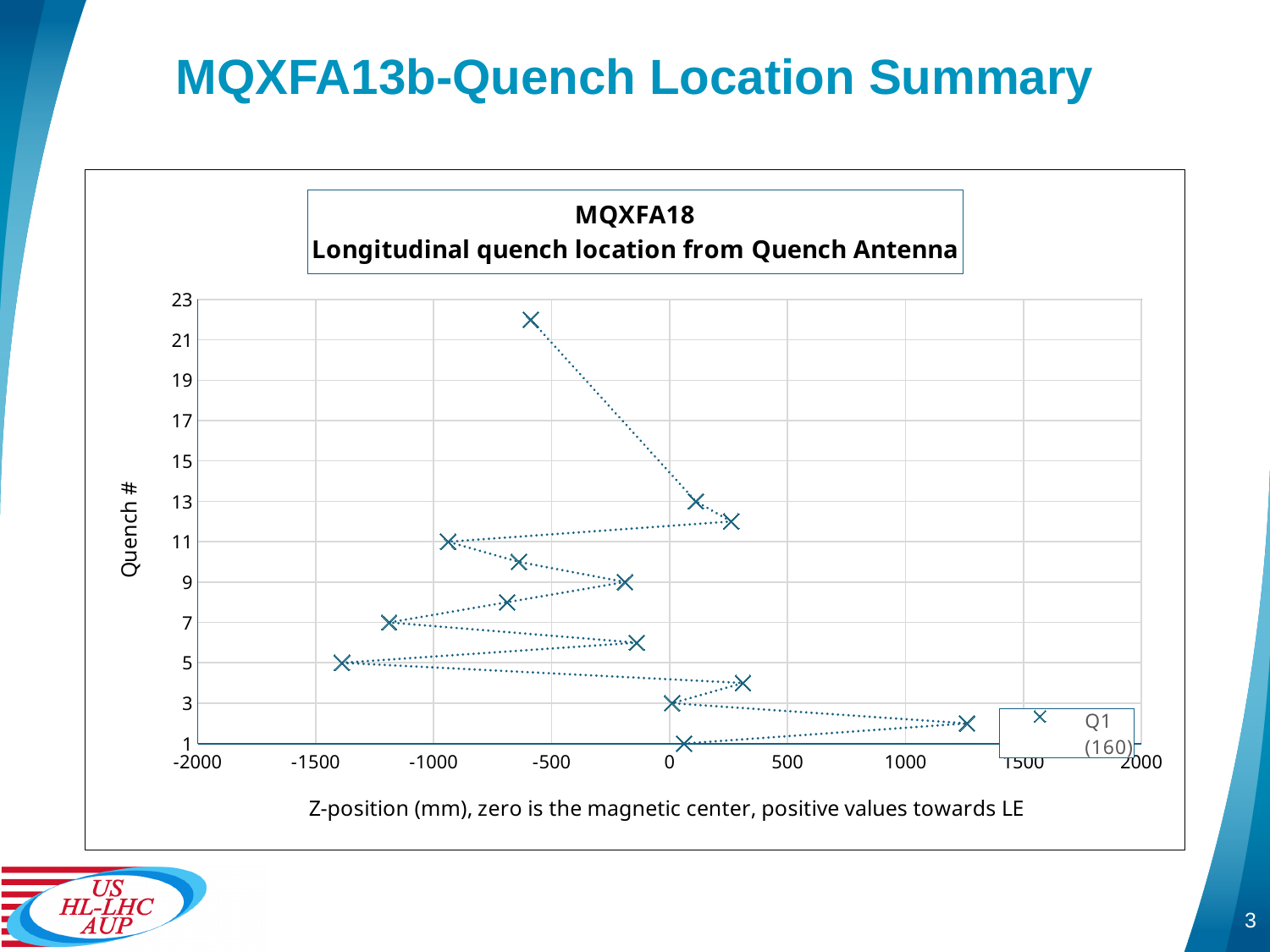
Is the Z-position for quench 2 greater or less than 1000? greater How many data points are plotted on the chart? 14 Is the Z-position for quench 22 greater or less than 0? less Which quench number has the smallest (most negative) Z-position? 5 Which has the larger Z-position, quench 2 or quench 4? quench 2 Which quench number has the largest (most positive) Z-position? 2 What is the label of the x axis? Z-position (mm), zero is the magnetic center, positive values towards LE What kind of chart is shown on the slide? scatter chart What is the title of the chart? MQXFA18 Longitudinal quench location from Quench Antenna Is the Z-position for quench 5 greater or less than -1000? less How many series does the legend list? 1